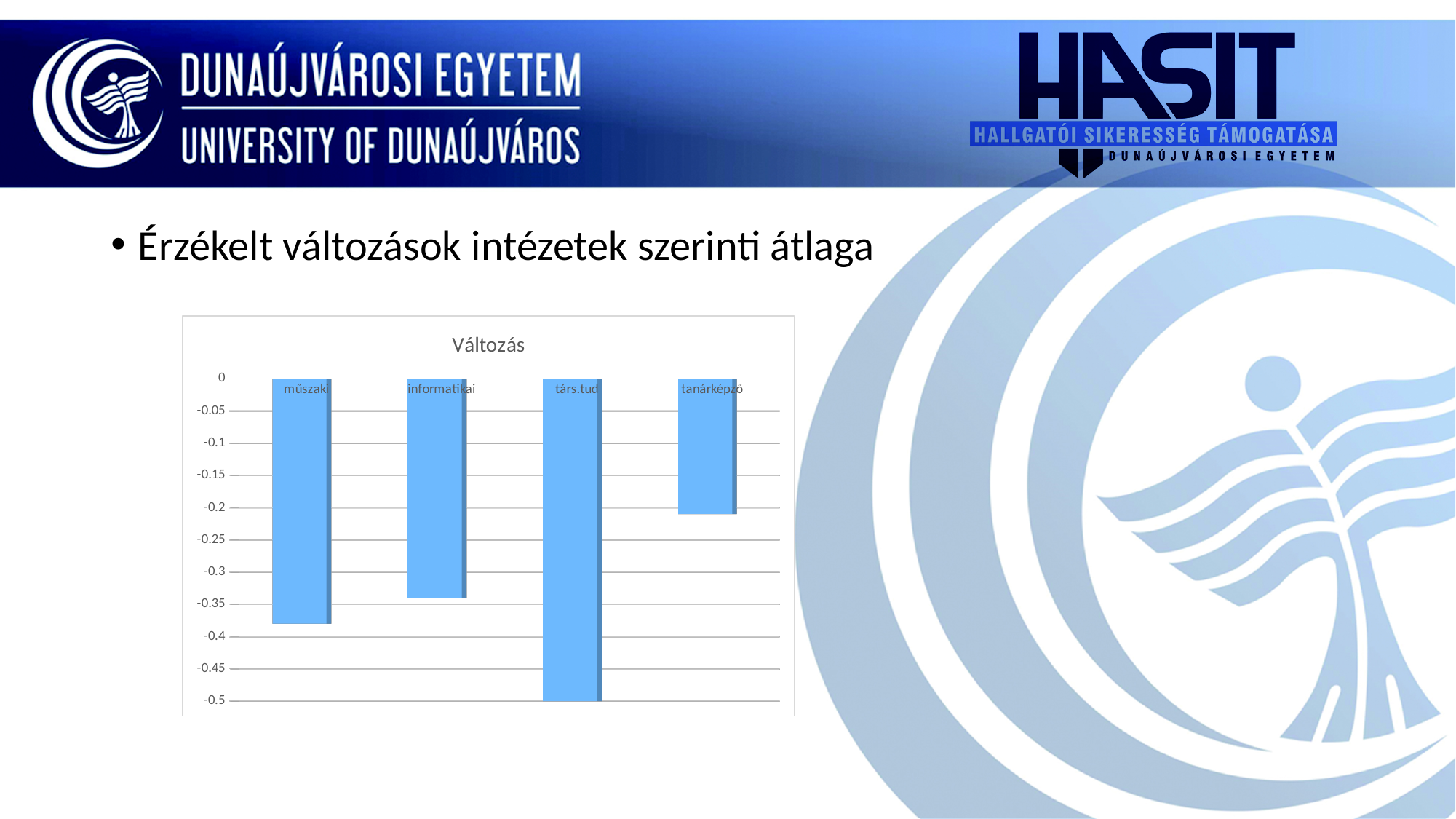
Is the value for műszaki greater or less than -0.35? less Which category has the highest value? tanárképző How many categories are shown in the chart? 4 Are all the values in the chart positive or negative? negative Which category has the lowest value? társ.tud What is the value for társ.tud? -0.5 Is the value for informatikai greater or less than -0.3? less Is the value for tanárképző greater or less than -0.25? greater Which has the larger value, műszaki or tanárképző? tanárképző What is the title of the chart? Változás Which has the larger value, informatikai or társ.tud? informatikai What kind of chart is shown on the slide? bar chart